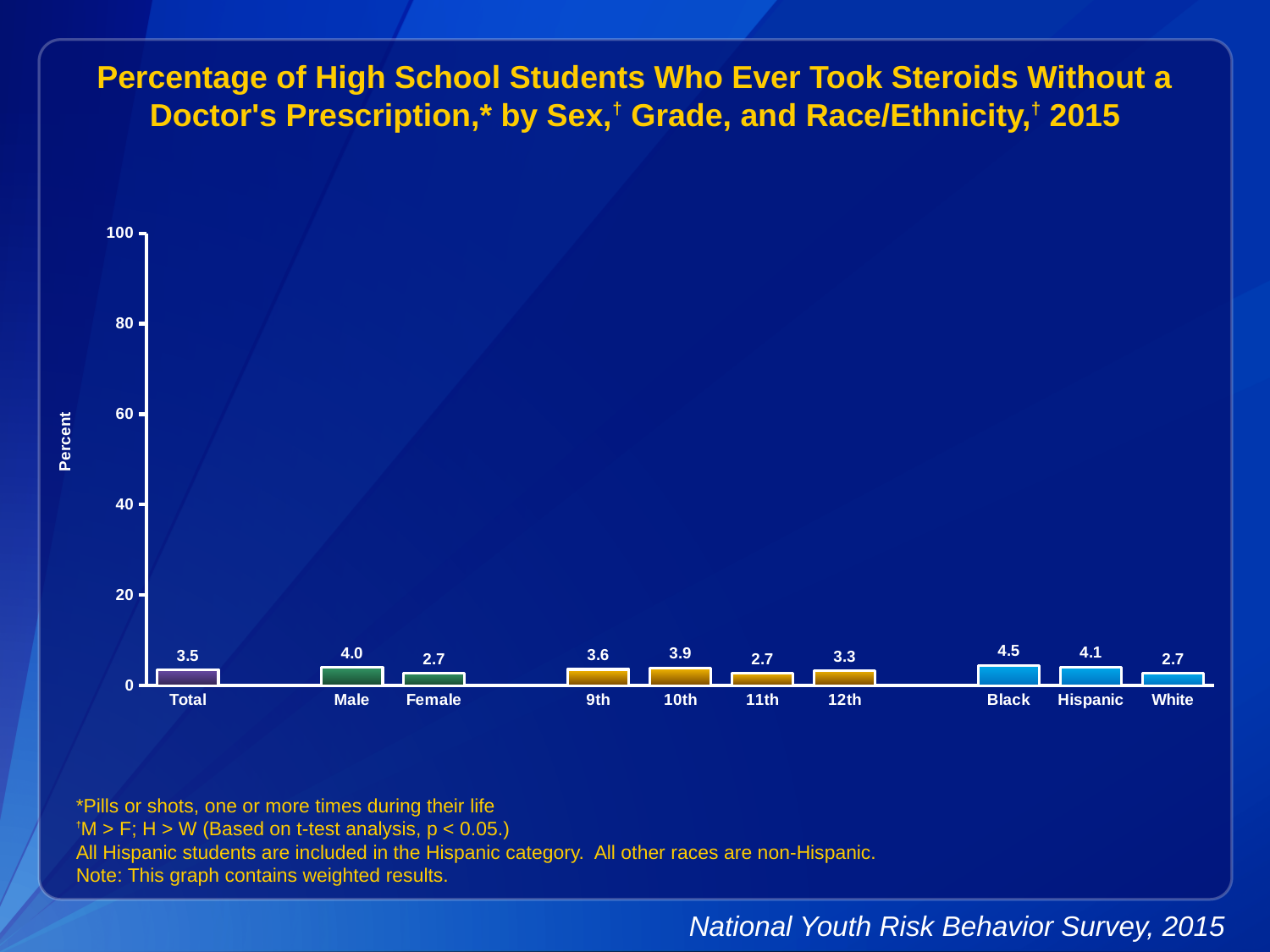
What is the difference between the Male and Female values? 1.3 How many categories are shown on the x axis? 10 What is the value for 10th grade? 3.9 What kind of chart is this? bar chart What is the value for Total? 3.5 Which is larger, the value for 9th grade or the value for 12th grade? 9th What is the value for Hispanic students? 4.1 What is the label on the y axis? Percent What is the difference between the Black and White values? 1.8 Is the value for Black greater or less than 20? less Which category has the highest value? Black What is the value for Male? 4.0